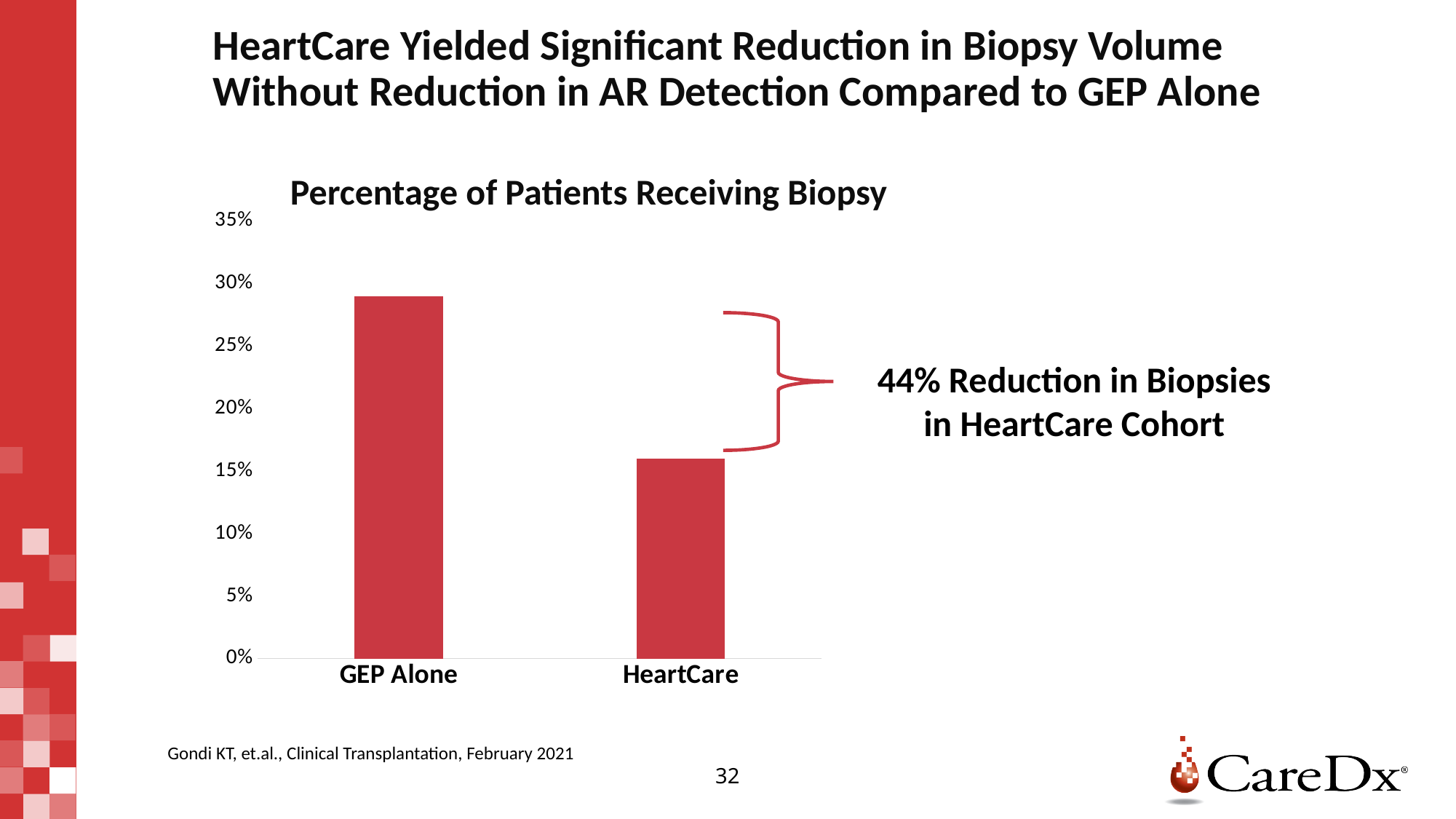
Is the value for HeartCare greater or less than 20%? less Which category has the lowest percentage of patients receiving biopsy? HeartCare Is the value for GEP Alone greater or less than 35%? less Which category has the highest percentage of patients receiving biopsy? GEP Alone What is the title of the chart? Percentage of Patients Receiving Biopsy Is the value for GEP Alone greater or less than 25%? greater Which is larger, the value for GEP Alone or the value for HeartCare? GEP Alone According to the annotation next to the chart, what reduction in biopsies was seen in the HeartCare cohort? 44% What type of chart is shown on the slide? bar chart How many categories are shown on the x axis of the chart? 2 Do the values fall or rise from GEP Alone to HeartCare along the x axis? fall